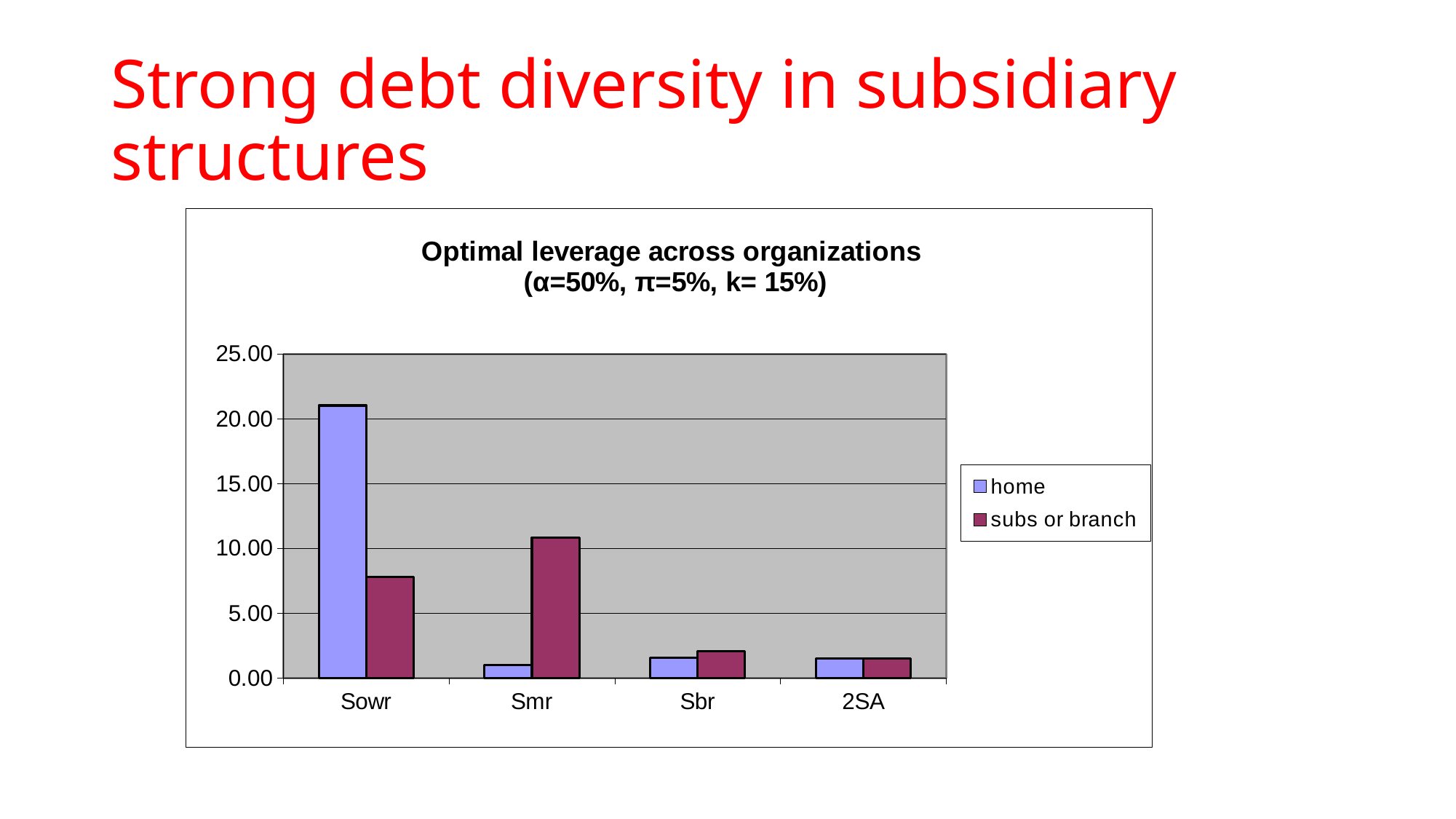
How many series does the legend list? 2 What kind of chart is shown on the slide? bar chart Which category has the highest value for the subs or branch series? Smr For Sowr, which is larger: the home value or the subs or branch value? home How many categories are shown on the x axis of the chart? 4 For Smr, which is larger: the home value or the subs or branch value? subs or branch Which category has the highest value for the home series? Sowr Is the home value for Sowr greater or less than 20.00? greater What are the two series named in the legend? home; subs or branch Is the subs or branch value for Sowr greater or less than 10.00? less Is the subs or branch value for Smr greater or less than 10.00? greater What is the title of the chart? Optimal leverage across organizations (α=50%, π=5%, k= 15%)